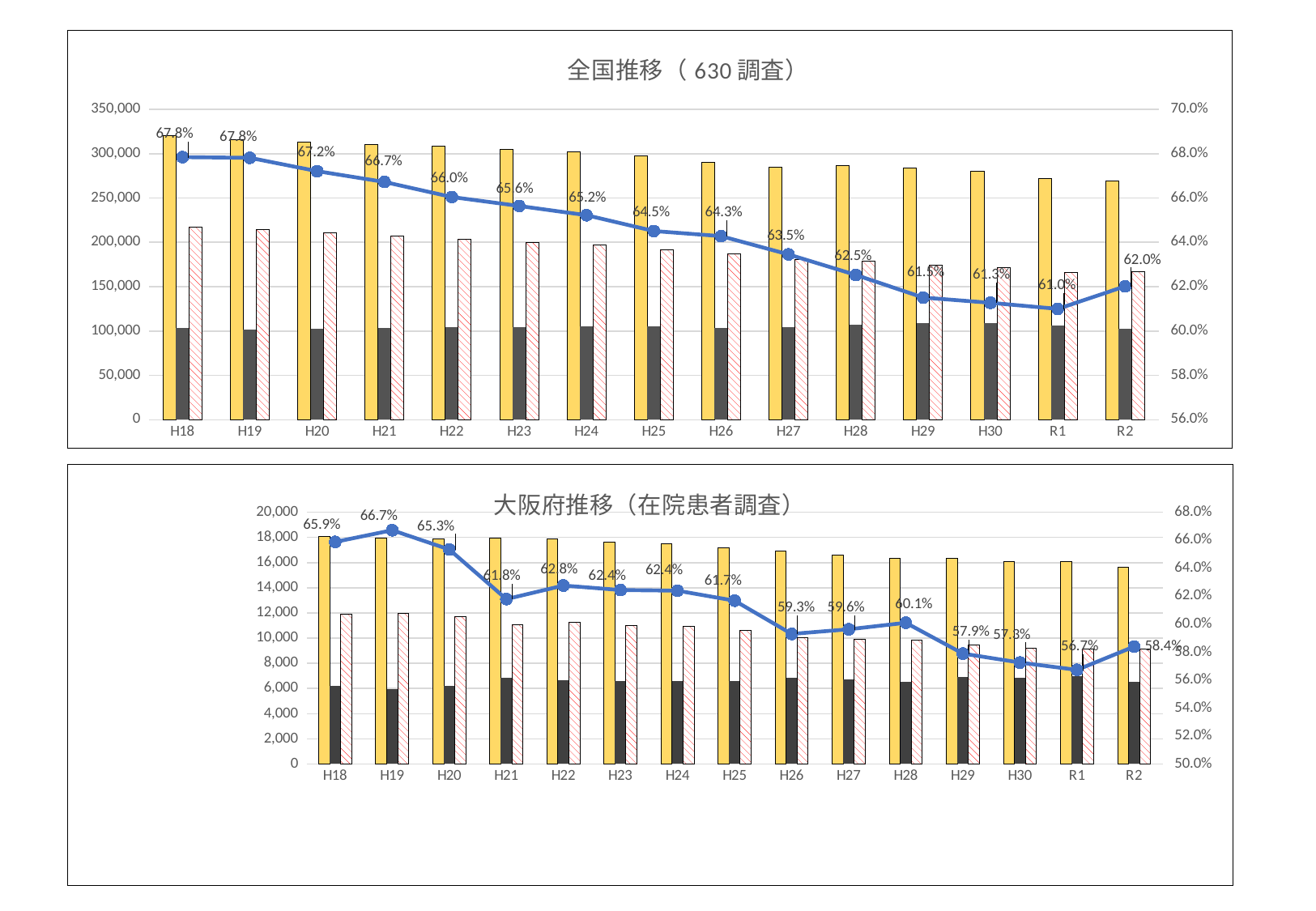
In the top chart titled 全国推移（630調査）, what is the line value labelled for H22? 66.0% In the top chart titled 全国推移（630調査）, which year has the lowest labelled line value? R1 In the bottom chart titled 大阪府推移（在院患者調査）, which year has the highest labelled line value? H19 In the bottom chart titled 大阪府推移（在院患者調査）, what is the line value labelled for H28? 60.1% In the bottom chart titled 大阪府推移（在院患者調査）, which is larger, the labelled line value for H26 or for H27? H27 In the top chart titled 全国推移（630調査）, what is the difference between the labelled line values for H18 and R2? 5.8% In the bottom chart titled 大阪府推移（在院患者調査）, does the line generally rise or fall from H18 to R1? fall In the bottom chart titled 大阪府推移（在院患者調査）, what is the difference between the labelled line values for H19 and R1? 10.0% In the top chart titled 全国推移（630調査）, how many years are shown on the x axis? 15 In the top chart titled 全国推移（630調査）, is the yellow bar for H18 greater or less than 300,000? greater In the top chart titled 全国推移（630調査）, what is the line value labelled for R1? 61.0% What kind of chart is the top chart titled 全国推移（630調査）? Combined bar and line chart